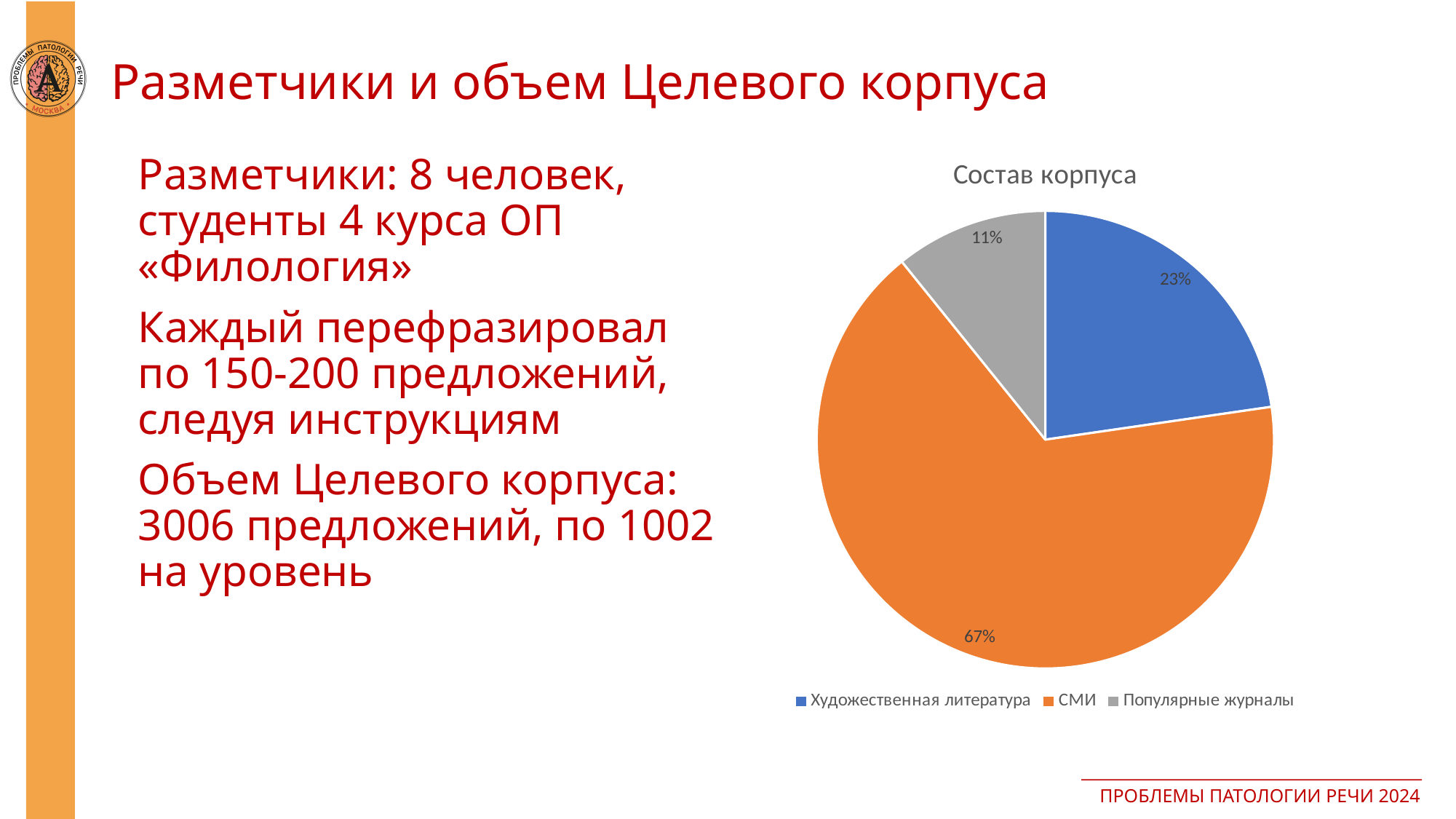
What type of chart is shown on the slide? pie chart What is the difference in percentage points between the СМИ slice and the Художественная литература slice? 44 What is the title of the chart? Состав корпуса How many entries does the legend list? 3 Which is larger, the slice for Художественная литература or the slice for Популярные журналы? Художественная литература What share of the pie does Популярные журналы take? 11% What share of the pie does Художественная литература take? 23% Which category has the smallest slice? Популярные журналы How many slices does the pie chart have? 3 Which category has the largest slice? СМИ What colour is the slice for СМИ? orange What share of the pie does СМИ take? 67%